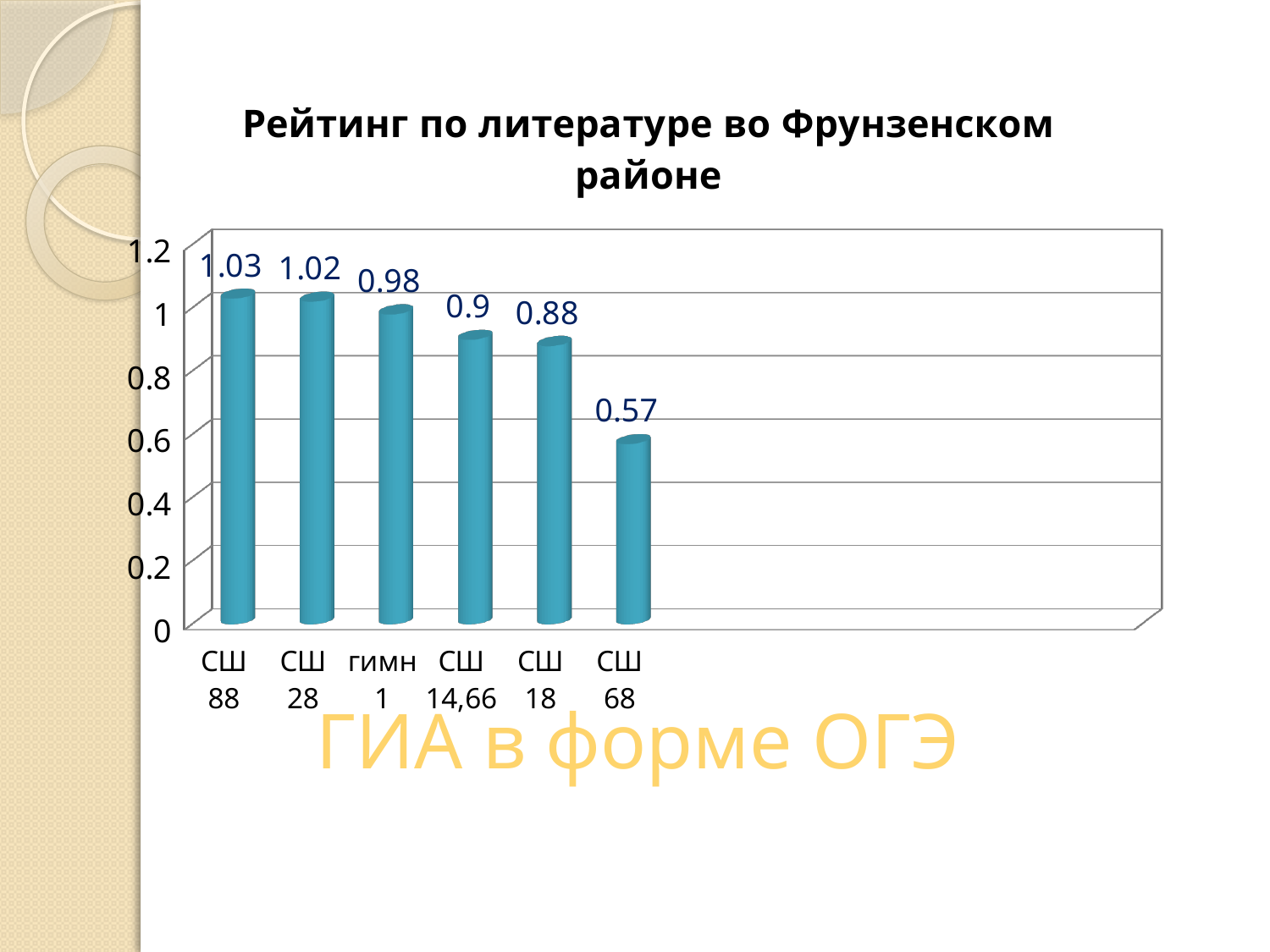
Which is larger, the value for СШ 28 or the value for СШ 18? СШ 28 What kind of chart is shown on the slide? bar chart What is the value for СШ 68? 0.57 Do the values rise or fall from left to right along the x axis? fall What is the value for СШ 88? 1.03 What is the title of the chart? Рейтинг по литературе во Фрунзенском районе Is the value for СШ 68 greater or less than 0.6? less What is the value for гимн 1? 0.98 How many categories are shown on the chart? 6 What is the value for СШ 14,66? 0.9 Which category has the lowest value? СШ 68 What is the difference between the values for СШ 18 and СШ 68? 0.31